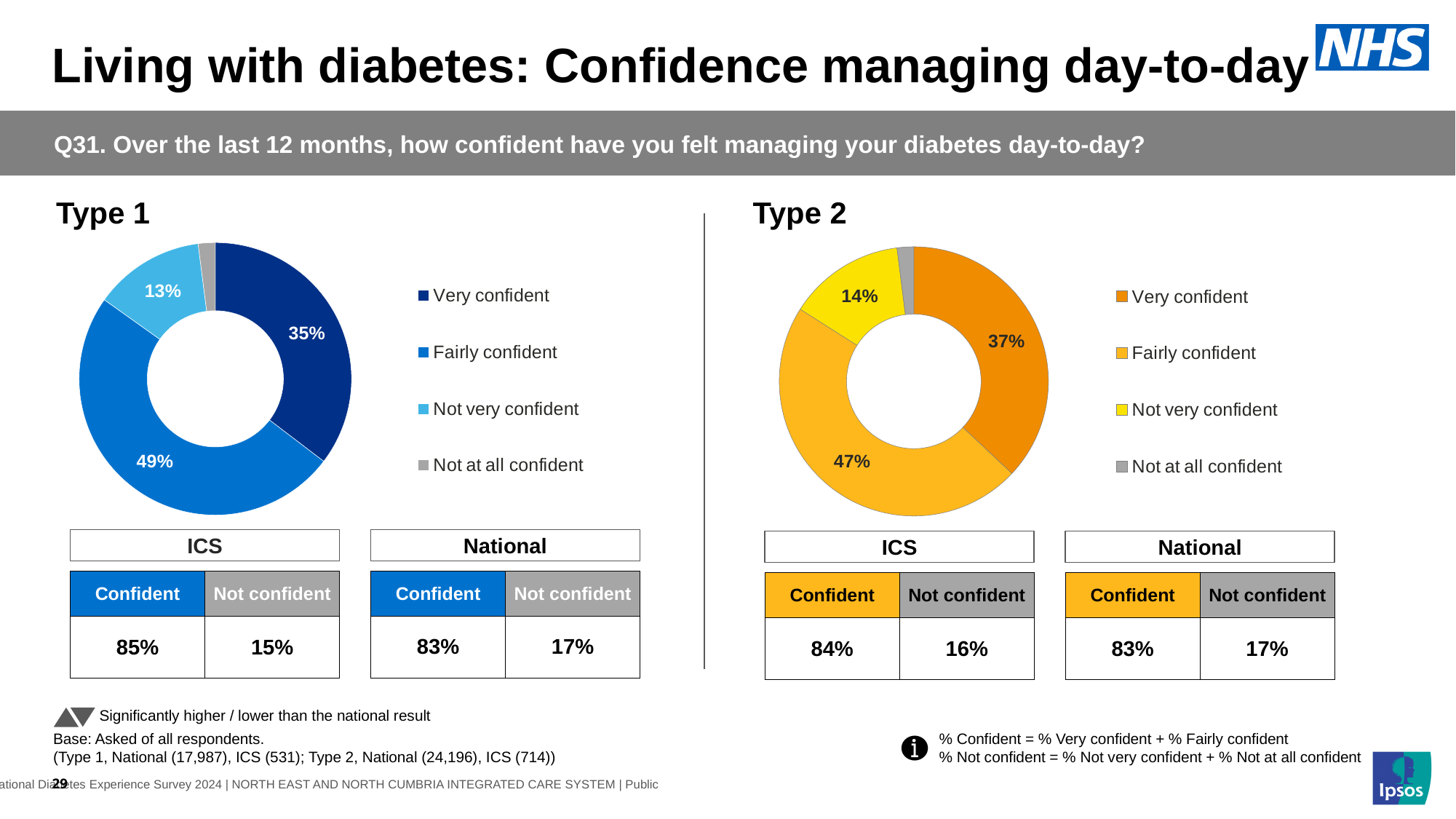
How many categories does the legend of the Type 2 chart list? 4 In the Type 1 chart, what percentage of respondents were not very confident? 13% What type of chart is used for Type 1 and Type 2? Donut (pie) chart In the Type 1 chart, what is the difference between the fairly confident and very confident shares? 14% In the Type 2 chart, what percentage of respondents were fairly confident? 47% In the Type 2 chart, what percentage of respondents were very confident? 37% In the Type 1 chart, what percentage of respondents were fairly confident? 49% Which is larger in the Type 2 chart: the very confident share or the not very confident share? Very confident In the Type 1 chart, which category has the largest share? Fairly confident In the Type 1 chart, what percentage of respondents were very confident? 35% In the Type 2 chart, what percentage of respondents were not very confident? 14% In the Type 2 chart, which category has the smallest share? Not at all confident